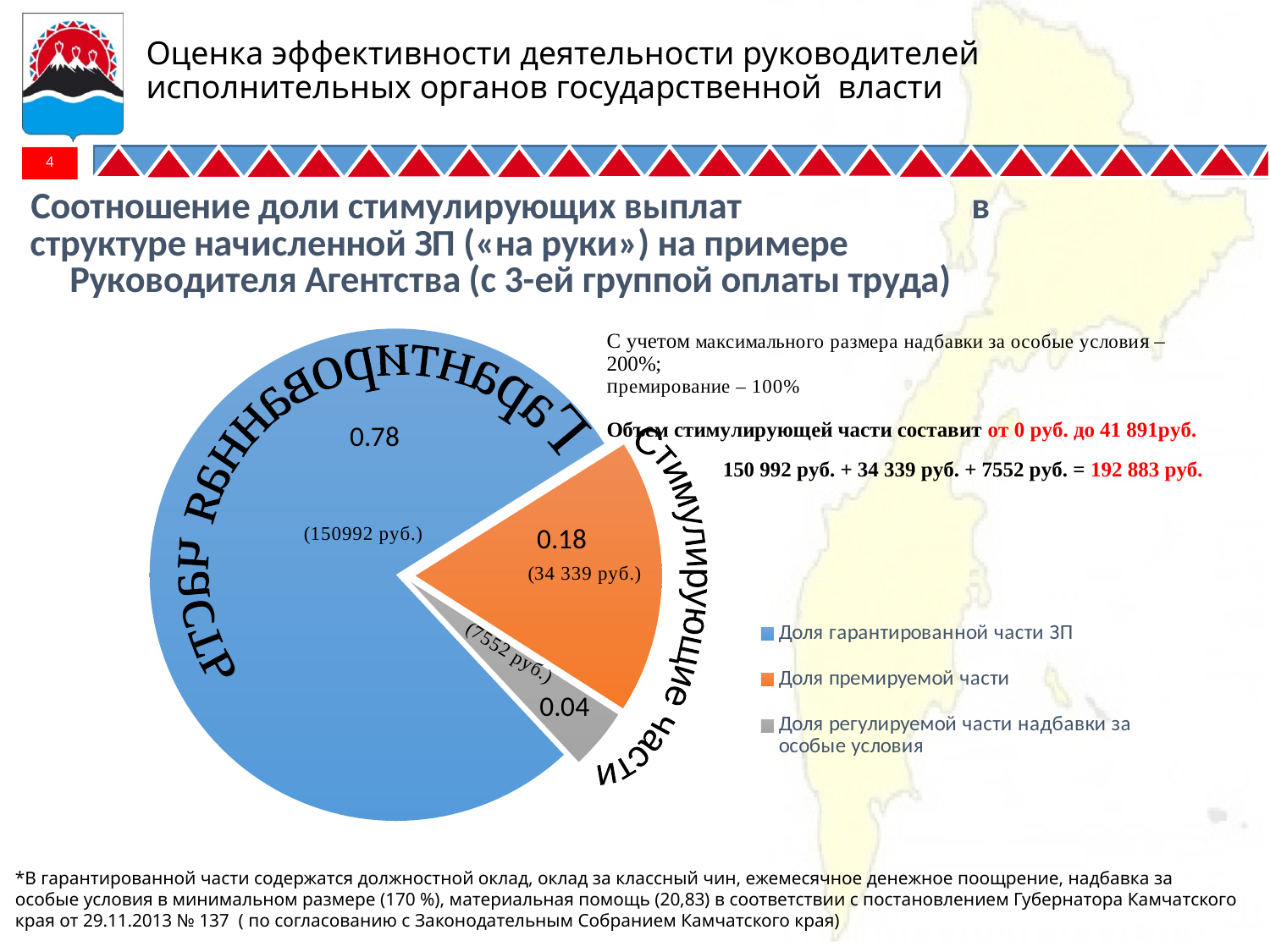
How many entries does the legend of the pie chart list? 3 What is the difference between the shares of "Доля гарантированной части ЗП" and "Доля премируемой части"? 0.60 What share is shown for the slice "Доля регулируемой части надбавки за особые условия"? 0.04 What share is shown for the slice "Доля гарантированной части ЗП"? 0.78 What share is shown for the slice "Доля премируемой части"? 0.18 Which slice of the pie chart is the largest? Доля гарантированной части ЗП What ruble amount is printed for the slice "Доля регулируемой части надбавки за особые условия"? 7552 руб. How many slices does the pie chart have? 3 What ruble amount is printed for the slice "Доля премируемой части"? 34 339 руб. Which slice of the pie chart is the smallest? Доля регулируемой части надбавки за особые условия What kind of chart is shown on the slide? pie chart Which colour represents "Доля премируемой части" in the pie chart? orange